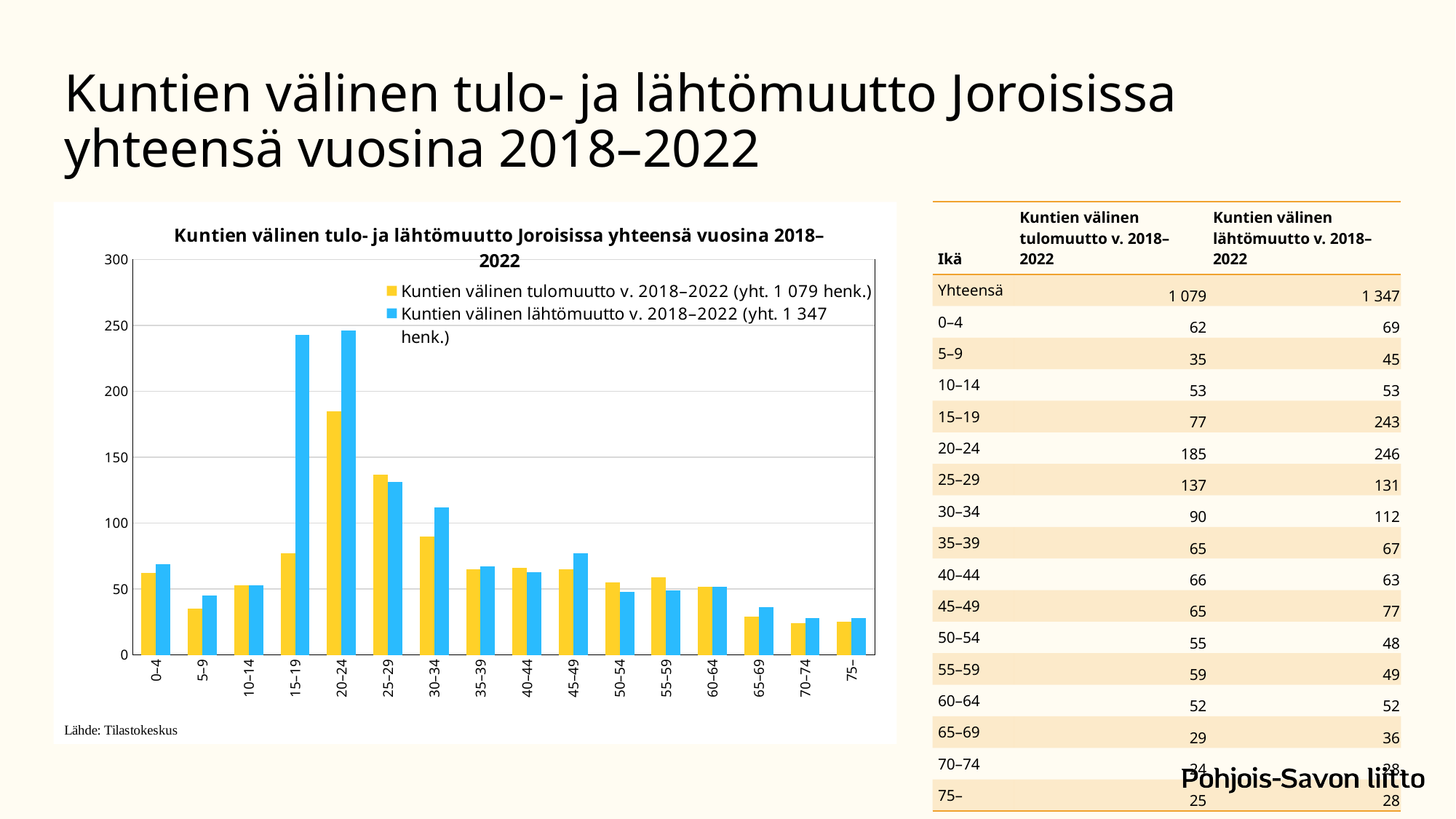
For the 15–19 age group, how much larger is lähtömuutto than tulomuutto? 166 What is the value of Kuntien välinen lähtömuutto v. 2018–2022 for the 15–19 age group? 243 For the 45–49 age group, which is larger: tulomuutto or lähtömuutto? lähtömuutto How many series does the chart's legend list? 2 After the 20–24 age group, do the tulomuutto values generally rise or fall across the older age groups? fall According to the legend, what is the total number of people for Kuntien välinen tulomuutto v. 2018–2022? 1 079 henk. What is the value of Kuntien välinen tulomuutto v. 2018–2022 for the 25–29 age group? 137 Is the value of lähtömuutto for the 30–34 age group greater or less than 100? greater How many age groups are shown on the x axis of the chart? 16 Is the value of tulomuutto for the 15–19 age group greater or less than 100? less What kind of chart is shown on the slide? bar chart Which age group has the highest value for Kuntien välinen tulomuutto v. 2018–2022? 20–24